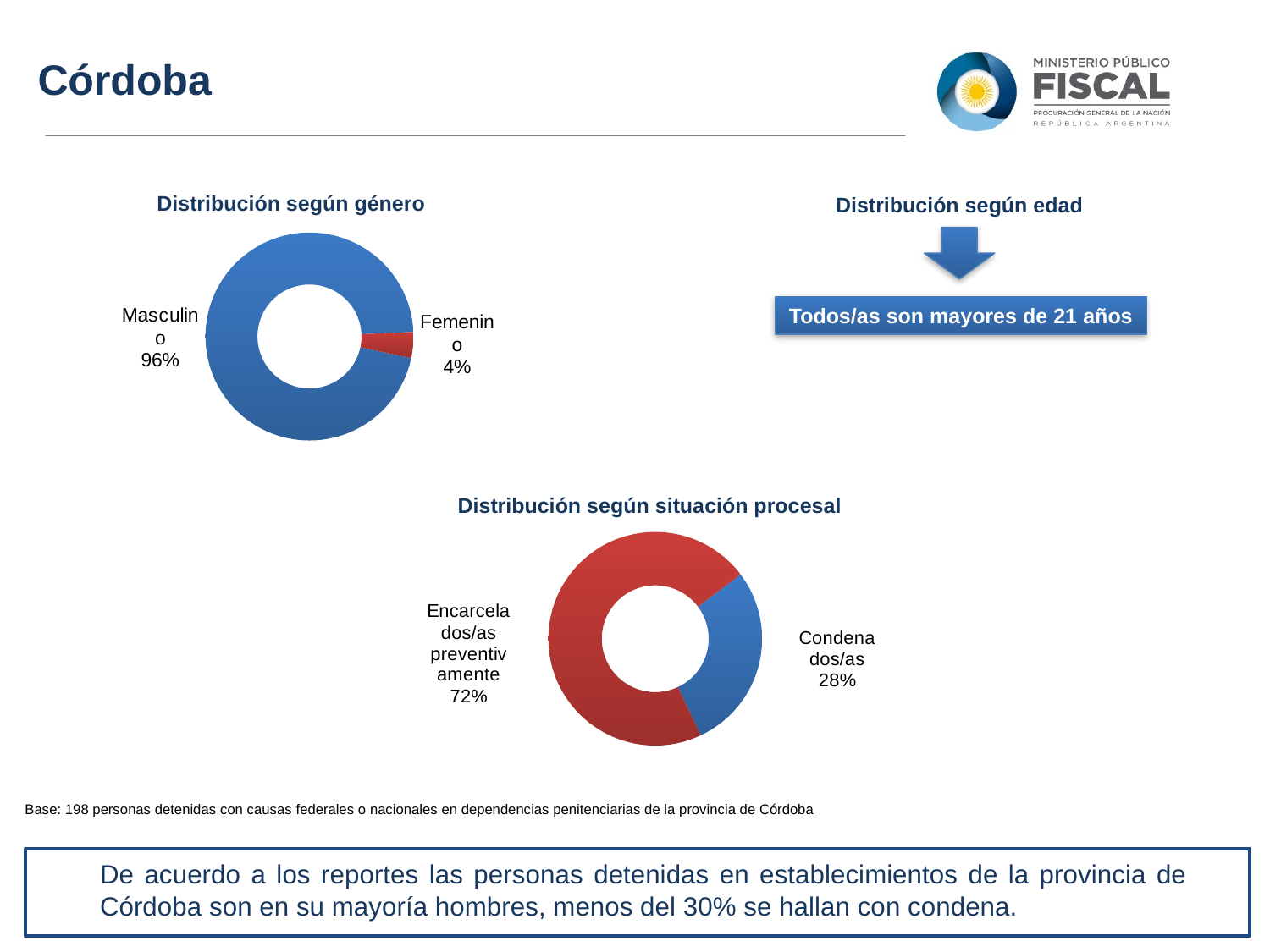
In the 'Distribución según situación procesal' chart, which is larger: Encarcelados/as preventivamente or Condenados/as? Encarcelados/as preventivamente In the 'Distribución según situación procesal' chart, what is the difference in percentage points between Encarcelados/as preventivamente and Condenados/as? 44 In the 'Distribución según género' chart, what percentage is Femenino? 4% In the 'Distribución según situación procesal' chart, which category has the smallest share? Condenados/as In the 'Distribución según género' chart, what is the difference in percentage points between Masculino and Femenino? 92 In the 'Distribución según situación procesal' chart, what percentage is Encarcelados/as preventivamente? 72% In the 'Distribución según género' chart, how many categories are shown? 2 What kind of chart is 'Distribución según género'? Doughnut (pie) chart In the 'Distribución según género' chart, which category has the largest share? Masculino In the 'Distribución según género' chart, what percentage is Masculino? 96% In the 'Distribución según situación procesal' chart, what percentage is Condenados/as? 28% In the 'Distribución según situación procesal' chart, what colour is the Condenados/as slice? Blue